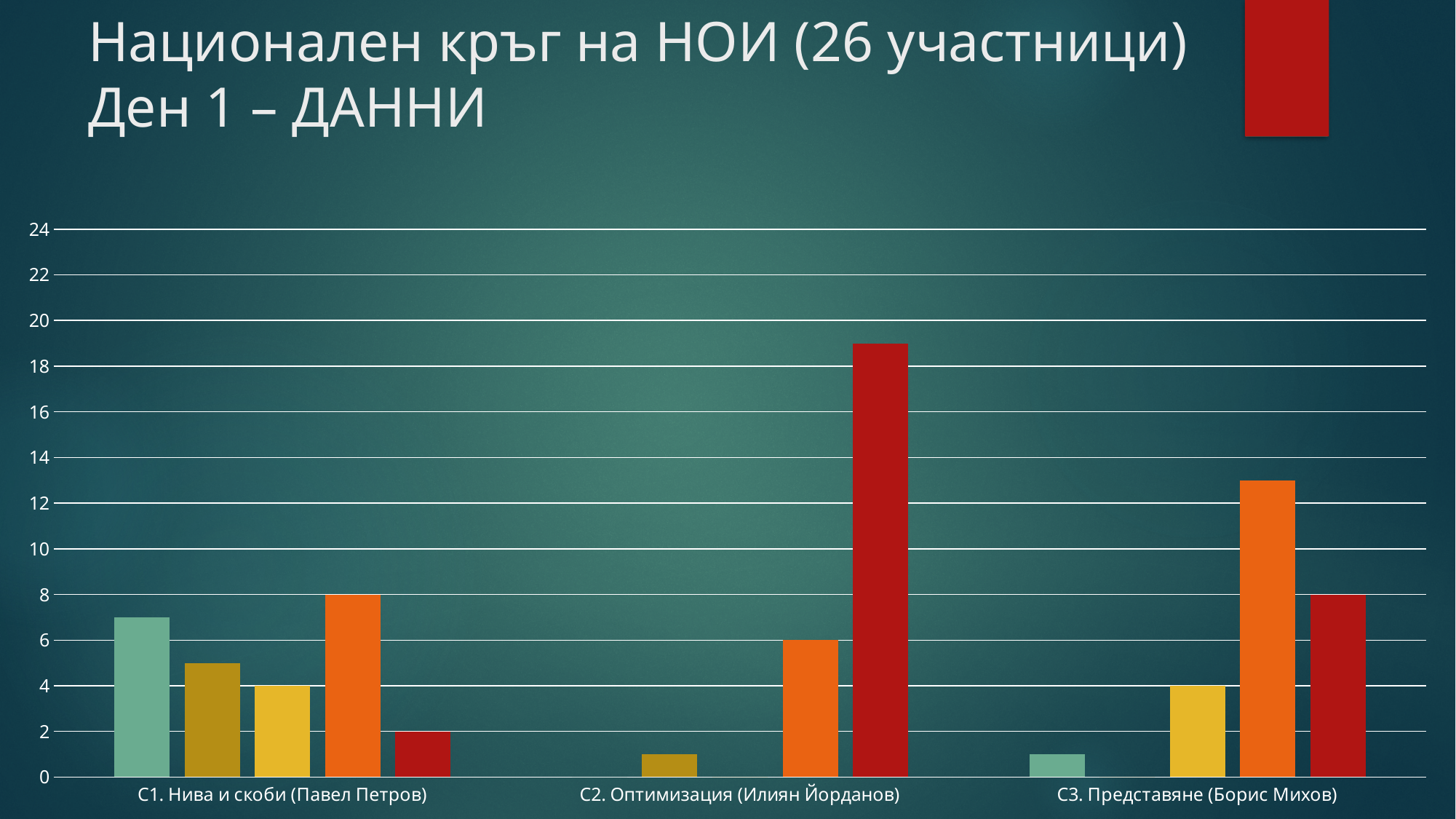
What kind of chart is shown on the slide? bar chart Which is larger: the dark red bar for C2. Оптимизация (Илиян Йорданов) or the orange bar for C3. Представяне (Борис Михов)? the dark red bar for C2. Оптимизация (Илиян Йорданов) Which category contains the tallest bar in the chart? C2. Оптимизация (Илиян Йорданов) How many categories are shown on the x axis of the chart? 3 Is the value of the orange bar for C3. Представяне (Борис Михов) greater or less than 12? greater Is the value of the dark red bar for C2. Оптимизация (Илиян Йорданов) greater or less than 18? greater What is the value of the dark red bar for C3. Представяне (Борис Михов)? 8 What is the value of the orange bar for C2. Оптимизация (Илиян Йорданов)? 6 What is the difference between the orange bar and the dark red bar for C1. Нива и скоби (Павел Петров)? 6 What is the value of the dark red bar for C1. Нива и скоби (Павел Петров)? 2 What is the value of the yellow bar for C3. Представяне (Борис Михов)? 4 What is the value of the orange bar for C1. Нива и скоби (Павел Петров)? 8